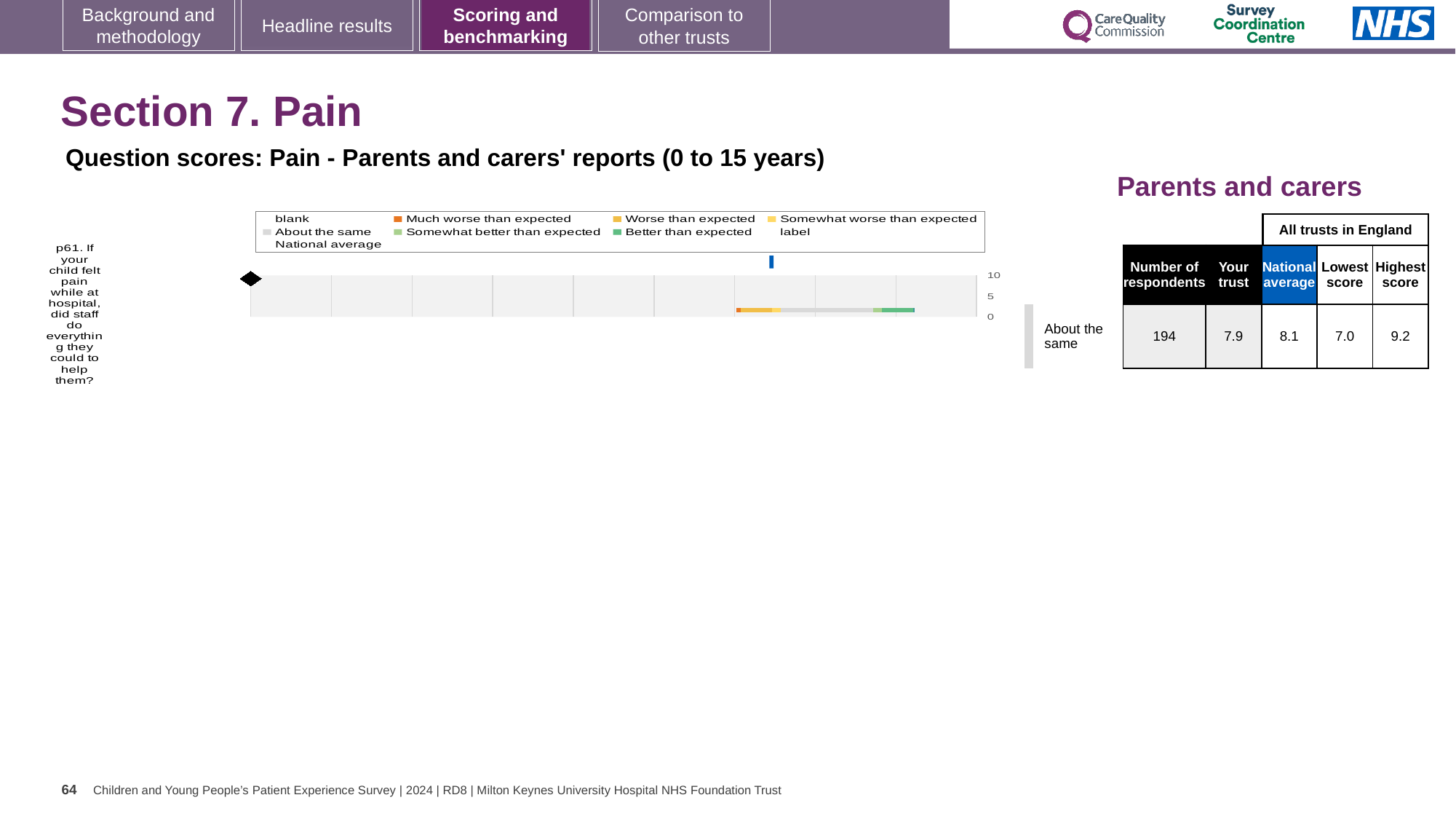
In the chart legend, what colour represents 'Much worse than expected'? orange What does the blue marker above the bar in the chart represent, according to the legend? National average According to the table beside the chart, what is the highest score among all trusts in England for question p61? 9.2 What benchmarking category is the trust's score for question p61 placed in? About the same According to the table beside the chart, what is the lowest score among all trusts in England for question p61? 7.0 According to the table beside the chart, how many respondents answered question p61? 194 According to the table beside the chart, what is the 'Your trust' score for question p61? 7.9 What type of chart is used to show the p61 question score? bar chart How many survey questions are plotted in the chart? 1 For question p61, which is larger: the 'Your trust' score or the national average? National average According to the table beside the chart, what is the national average score for question p61? 8.1 For question p61, what is the difference between the highest score and the lowest score among all trusts in England? 2.2